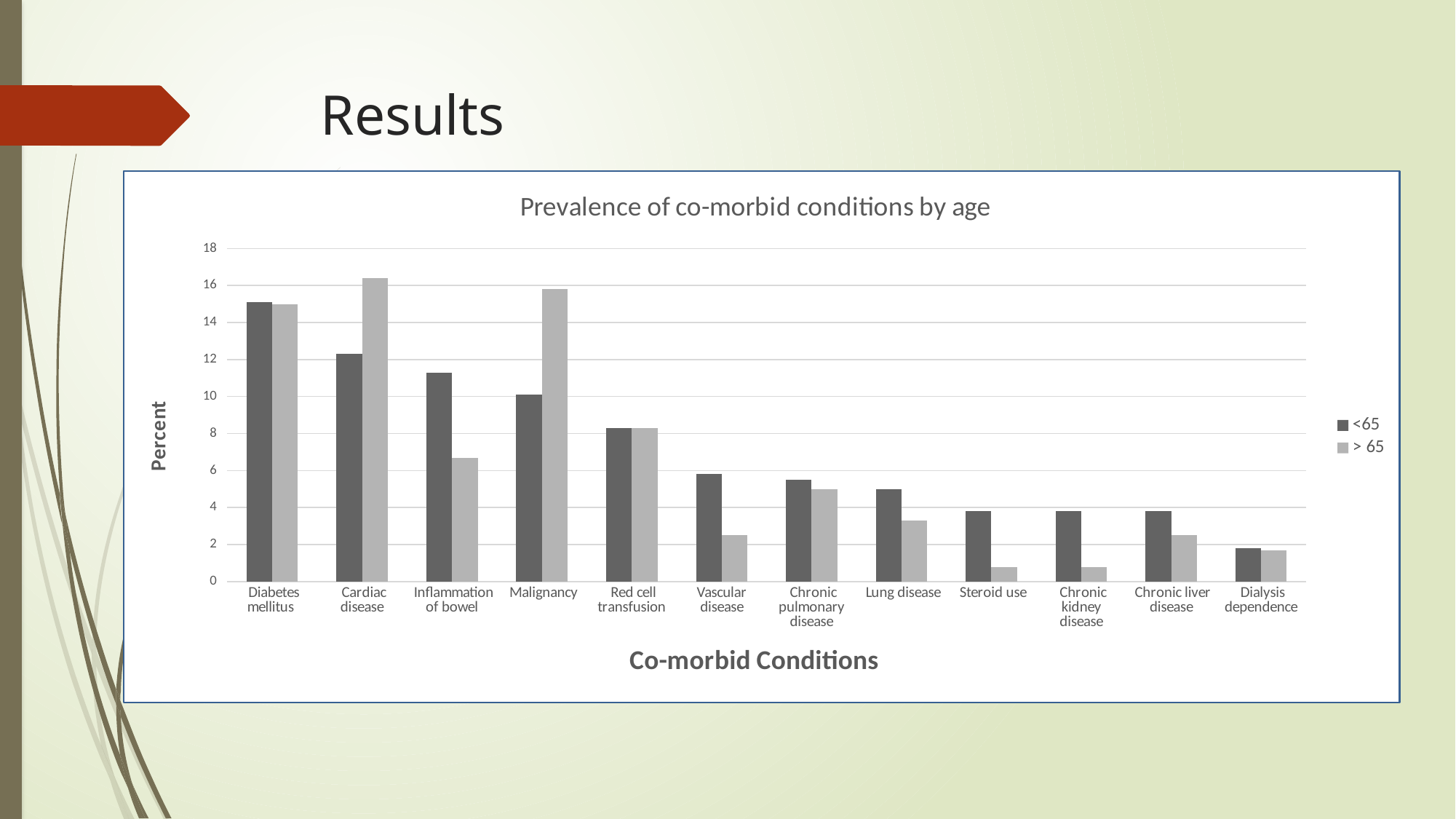
For Malignancy, which series has the larger value, <65 or > 65? > 65 Is the value for Cardiac disease in the > 65 series greater or less than 16? greater Is the value for Vascular disease in the > 65 series greater or less than 4? less Which co-morbid condition has the highest value for the <65 series? Diabetes mellitus How many series does the legend list? 2 Which co-morbid condition has the lowest value for the <65 series? Dialysis dependence What kind of chart is shown on the slide? bar chart How many co-morbid conditions are shown on the x axis? 12 Which co-morbid condition has the highest value for the > 65 series? Cardiac disease For Inflammation of bowel, which series has the larger value, <65 or > 65? <65 What is the title of the chart? Prevalence of co-morbid conditions by age What is the label of the y axis? Percent